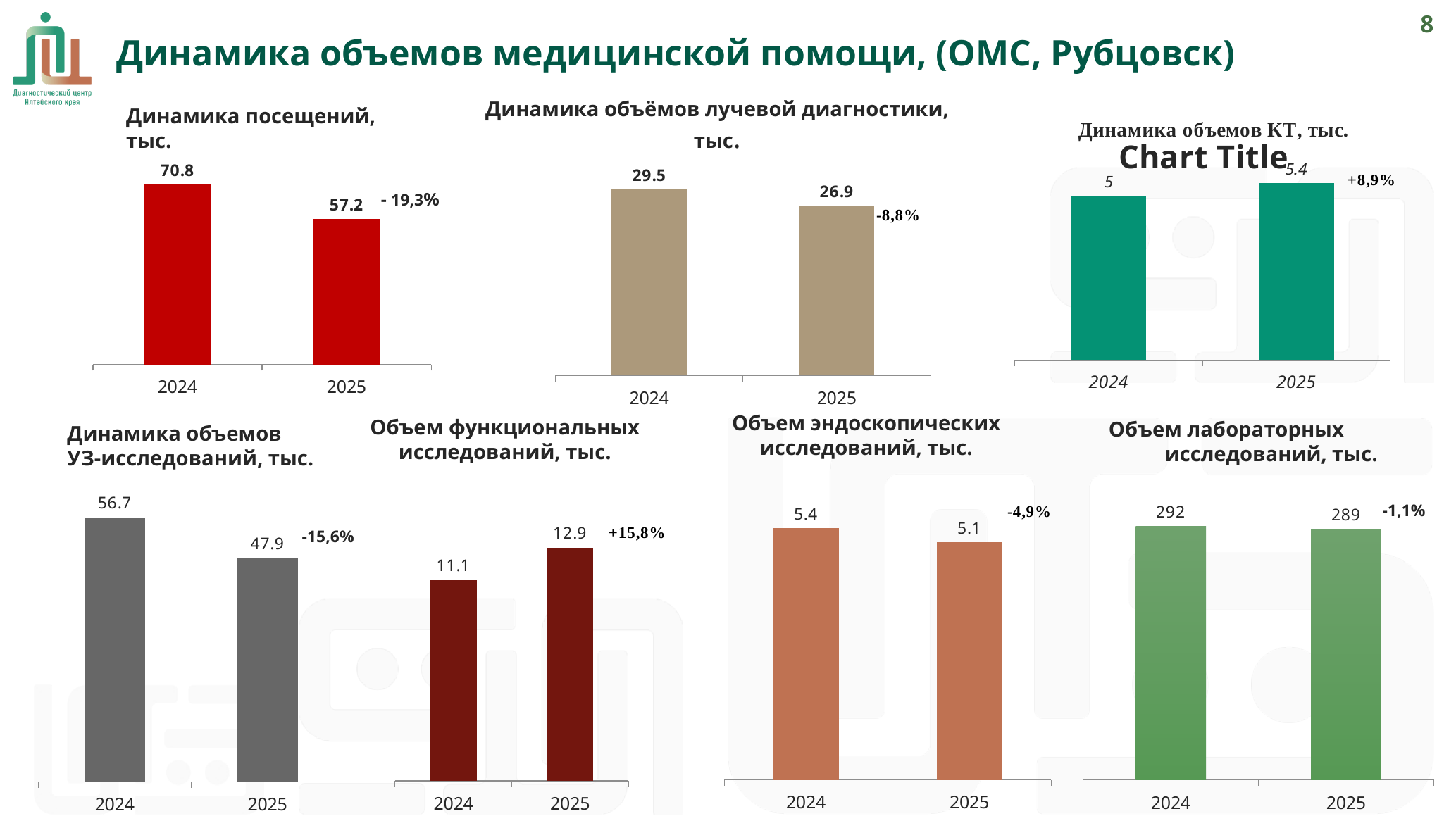
In the chart 'Объем функциональных исследований, тыс.', what is the difference between the 2025 and 2024 values? 1.8 In the chart 'Динамика посещений, тыс.', what is the difference between the 2024 and 2025 values? 13.6 What type of chart is 'Динамика объемов УЗ-исследований, тыс.'? bar chart In the chart 'Динамика объемов КТ, тыс.', do the values rise or fall from 2024 to 2025? rise In the chart 'Динамика объемов УЗ-исследований, тыс.', what is the value for 2025? 47.9 In the chart 'Динамика объемов КТ, тыс.', what is the value for 2025? 5.4 In the chart 'Динамика объёмов лучевой диагностики, тыс.', what is the value for 2025? 26.9 In the chart 'Объем эндоскопических исследований, тыс.', which year has the lower value? 2025 In the chart 'Объем лабораторных исследований, тыс.', what is the value for 2024? 292 How many bars are plotted in the chart 'Объем лабораторных исследований, тыс.'? 2 In the chart 'Динамика объёмов лучевой диагностики, тыс.', which year has the higher value? 2024 In the chart 'Динамика посещений, тыс.', what is the value for 2024? 70.8